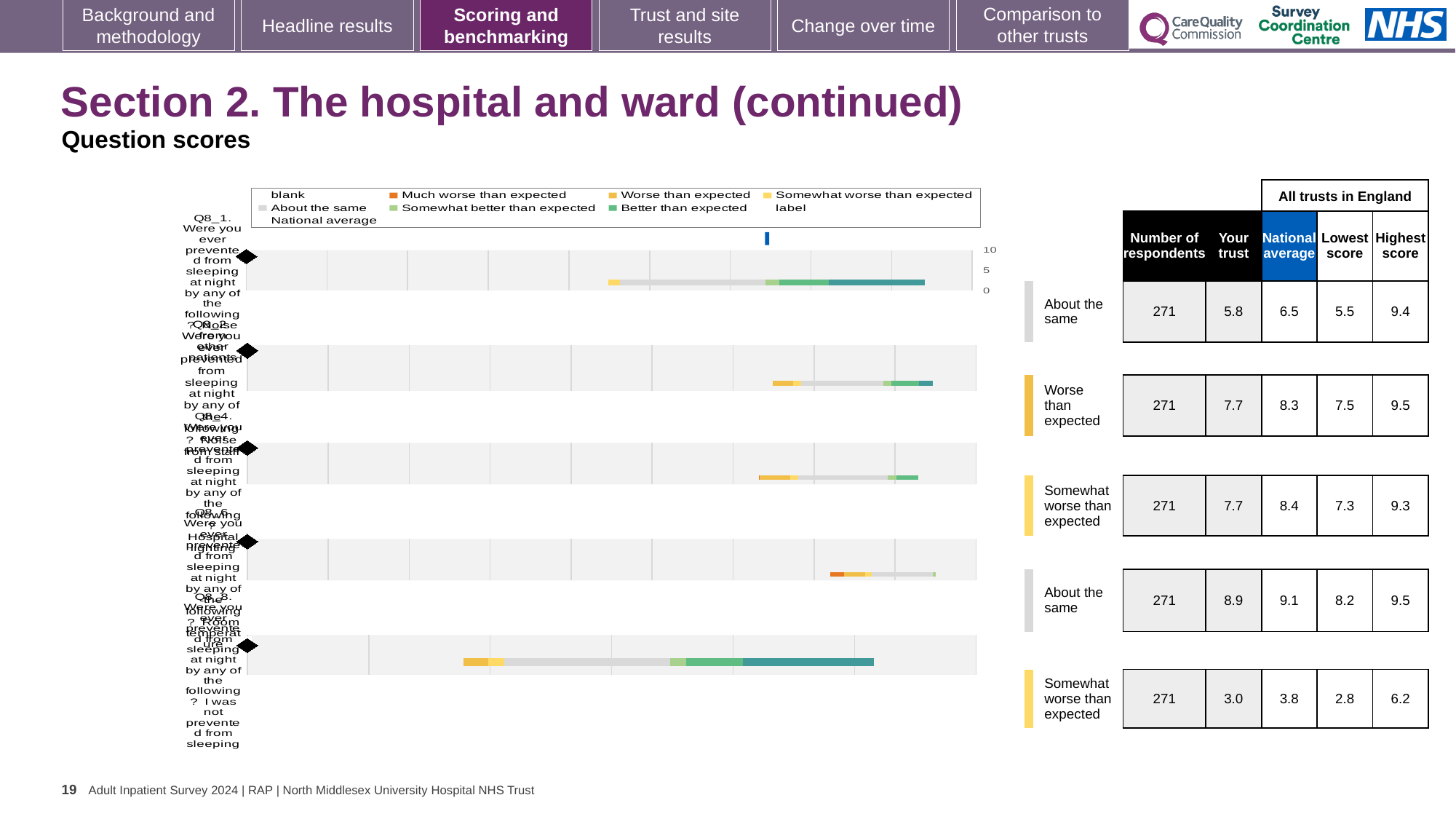
In the table, what is the 'Your trust' score in the first row? 5.8 What is the number of respondents shown for each row of the table? 271 In the table, what is the 'Lowest score' in the third row? 7.3 In the table, what is the 'National average' score in the fifth (bottom) row? 3.8 In the first row of the table, what is the difference between the National average and the Your trust score? 0.7 How many horizontal bars (question rows) does the chart contain? 5 What kind of chart is shown on the left of the slide? bar chart Which row of the table has the highest 'Your trust' score? the fourth row (8.9) In the table, what is the 'Highest score' in the second row? 9.5 What benchmark label is shown next to the bottom bar of the chart? Somewhat worse than expected In the second row of the table, which is larger: the Your trust score or the National average? National average Which row of the table has the lowest 'Your trust' score? the fifth row (3.0)